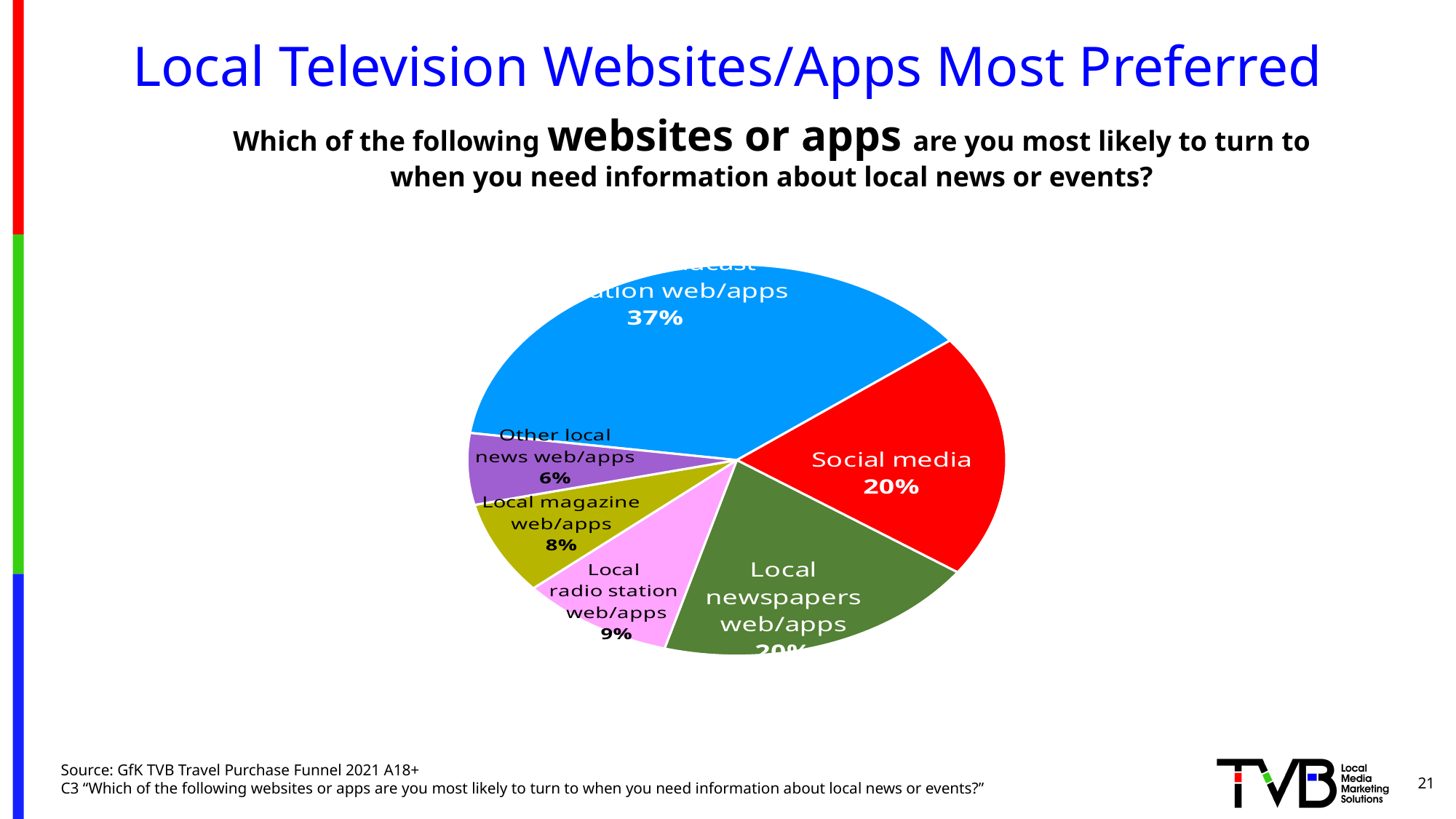
What is the difference between Local magazine web/apps and Other local news web/apps? 2% What is the value for Local radio station web/apps? 9% What colour is the Social media slice? red What is the value for Local magazine web/apps? 8% What is the difference between the Social media share and the Local radio station web/apps share? 11% What is the title of the slide? Local Television Websites/Apps Most Preferred Which category has the smallest slice of the pie? Other local news web/apps What is the value for Other local news web/apps? 6% How many slices does the pie chart have? 6 What type of chart is shown on the slide? pie chart What percentage of the pie is Social media? 20% Which is larger, Local radio station web/apps or Local magazine web/apps? Local radio station web/apps